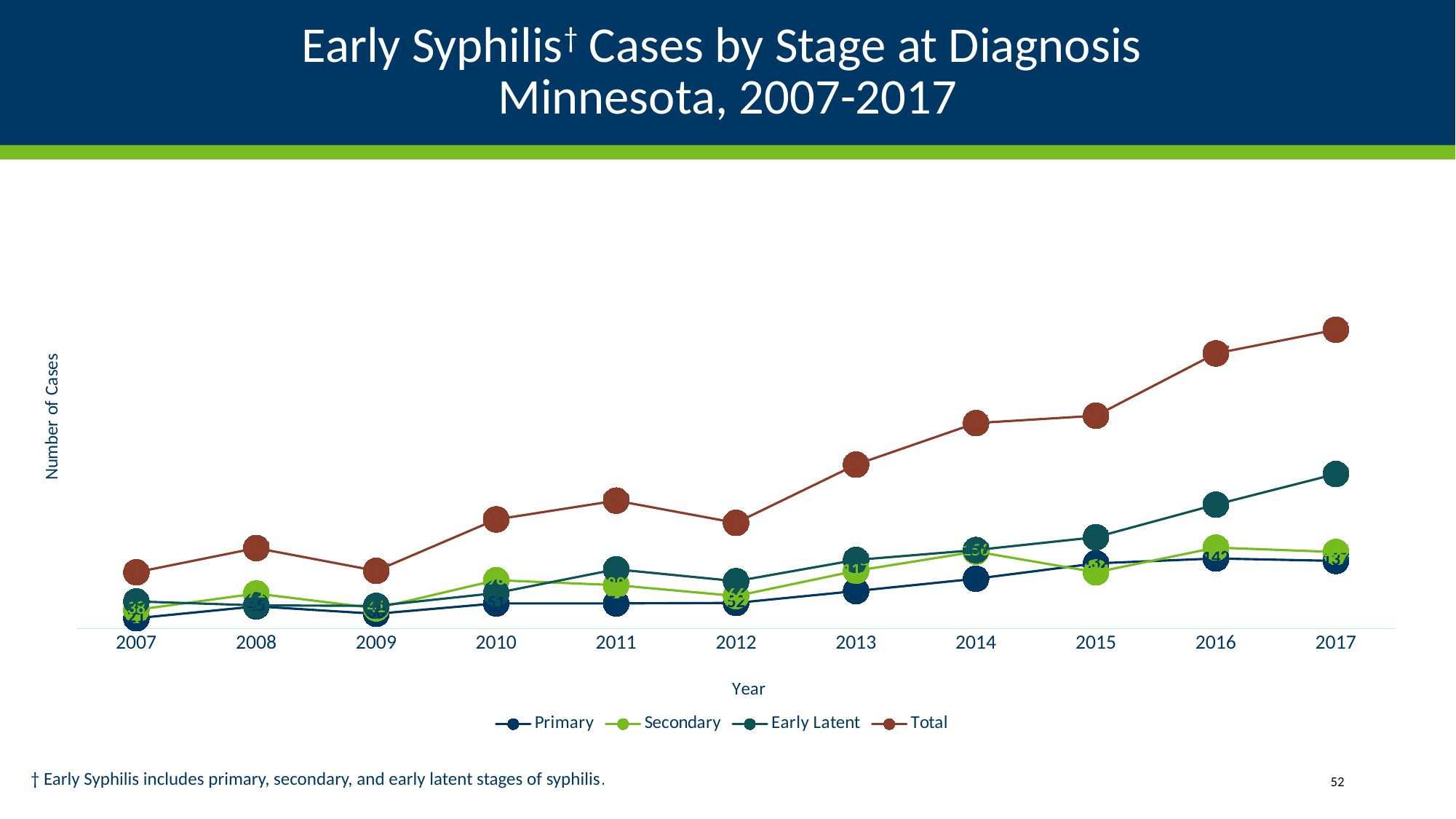
In which year is the Total series at its highest? 2017 What kind of chart is shown on the slide? line chart In 2017, which series has the lowest value? Primary How many years are plotted along the x axis? 11 In 2017, which is larger: Early Latent or Secondary? Early Latent How many series does the legend list? 4 Does the Total series generally rise or fall from 2007 to 2017? rise Which is larger for the Total series: 2012 or 2013? 2013 Which series has the highest values across all years? Total What is the label on the y axis? Number of Cases What are the four series listed in the legend? Primary, Secondary, Early Latent, Total Which is larger for the Total series: 2016 or 2017? 2017